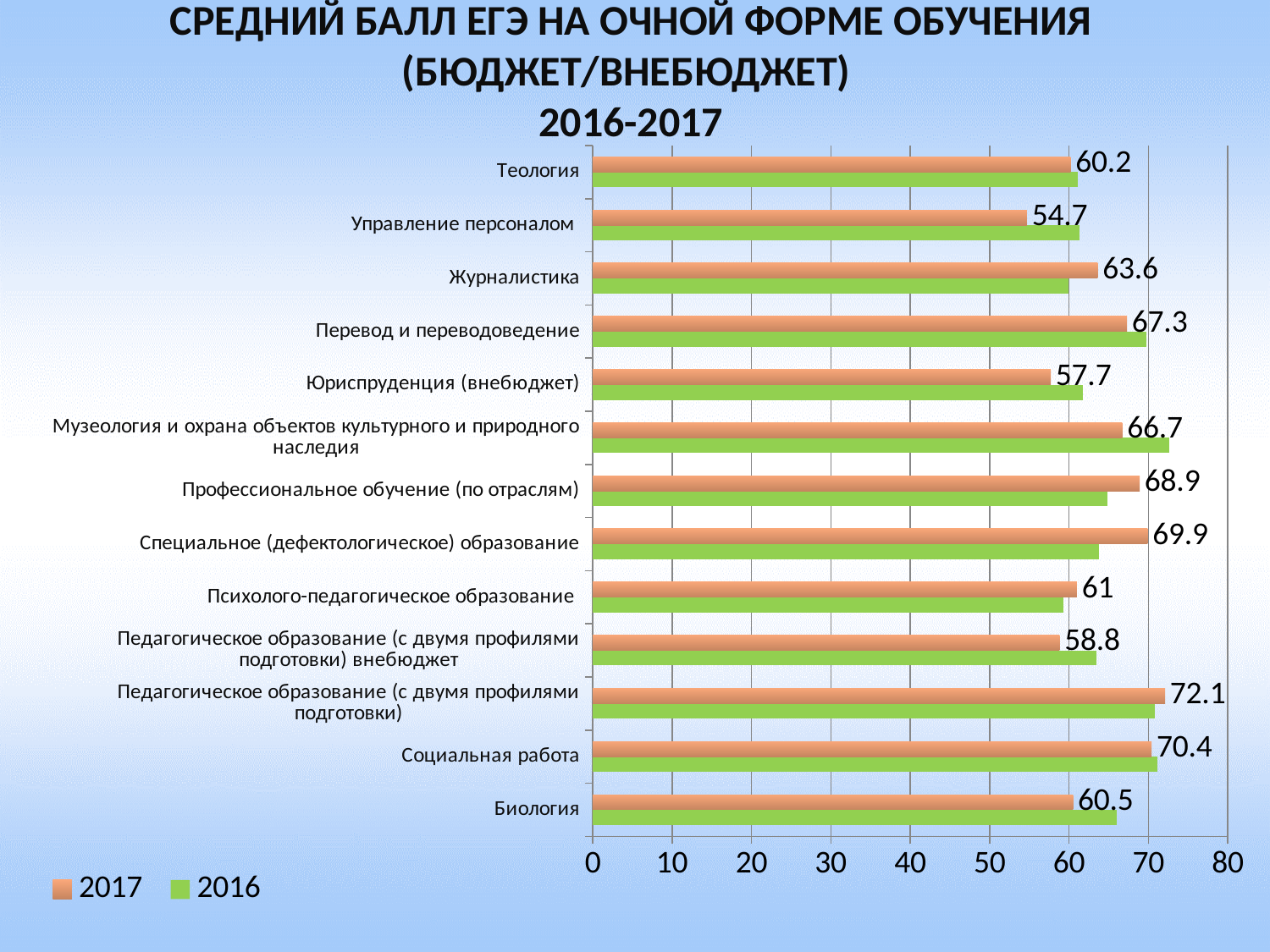
Which category has the highest 2017 value? Педагогическое образование (с двумя профилями подготовки) What is the 2017 value for Социальная работа? 70.4 How many categories are shown on the chart? 13 Which has the larger 2017 value, Профессиональное обучение (по отраслям) or Психолого-педагогическое образование? Профессиональное обучение (по отраслям) Which category has the lowest 2017 value? Управление персоналом Is the 2016 value for Музеология и охрана объектов культурного и природного наследия greater or less than 70? greater How many series does the legend list? 2 What is the difference between the 2017 values for Педагогическое образование (с двумя профилями подготовки) and Управление персоналом? 17.4 What is the 2017 value for Юриспруденция (внебюджет)? 57.7 What is the 2017 value for Журналистика? 63.6 What type of chart is shown on the slide? Bar chart Is the 2016 value for Биология greater or less than 60? greater